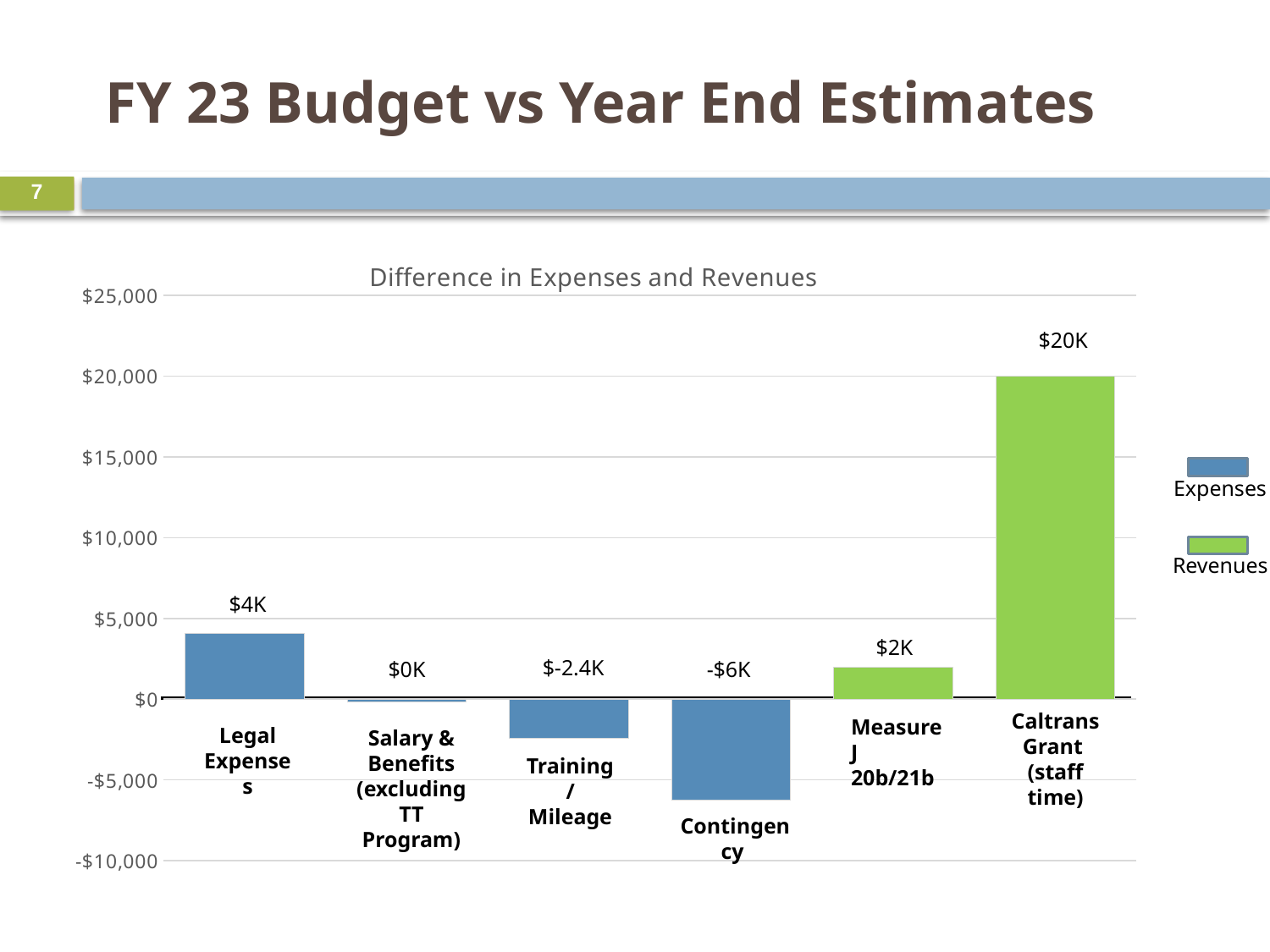
What type of chart is shown on the slide? bar chart What is the title of the chart? Difference in Expenses and Revenues What is the value shown for Legal Expenses? $4K Which category has the lowest value? Contingency How many categories are shown on the x axis? 6 Is the value for Caltrans Grant (staff time) greater or less than $15,000? greater What is the value shown for Caltrans Grant (staff time)? $20K What is the value shown for Contingency? -$6K How many series does the legend list? 2 What is the value shown for Measure J 20b/21b? $2K What is the value shown for Training / Mileage? $-2.4K Which category has the highest value? Caltrans Grant (staff time)